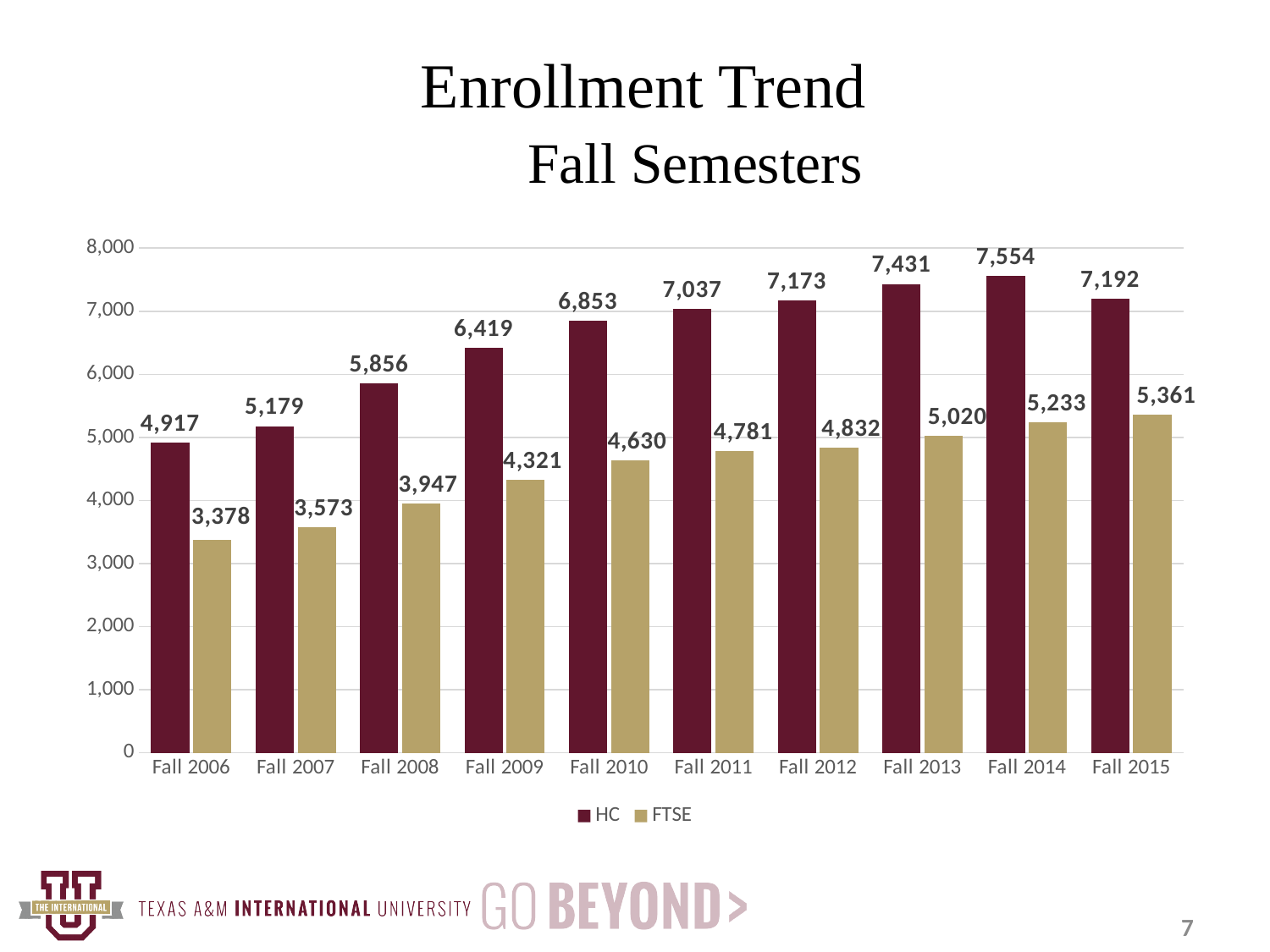
How many series does the legend list? 2 Which fall semester has the highest HC value? Fall 2014 What kind of chart is shown on the slide? Bar chart Which is larger, the HC value for Fall 2013 or the HC value for Fall 2015? Fall 2013 What is the difference between the HC and FTSE values for Fall 2015? 1,831 What is the FTSE value for Fall 2013? 5,020 By how much did the HC value change from Fall 2014 to Fall 2015? Decreased by 362 Does the FTSE value rise or fall from Fall 2006 to Fall 2015? Rise How many fall semesters are shown on the x axis? 10 Which fall semester has the lowest FTSE value? Fall 2006 What is the HC value for Fall 2010? 6,853 What are the two series named in the legend? HC and FTSE